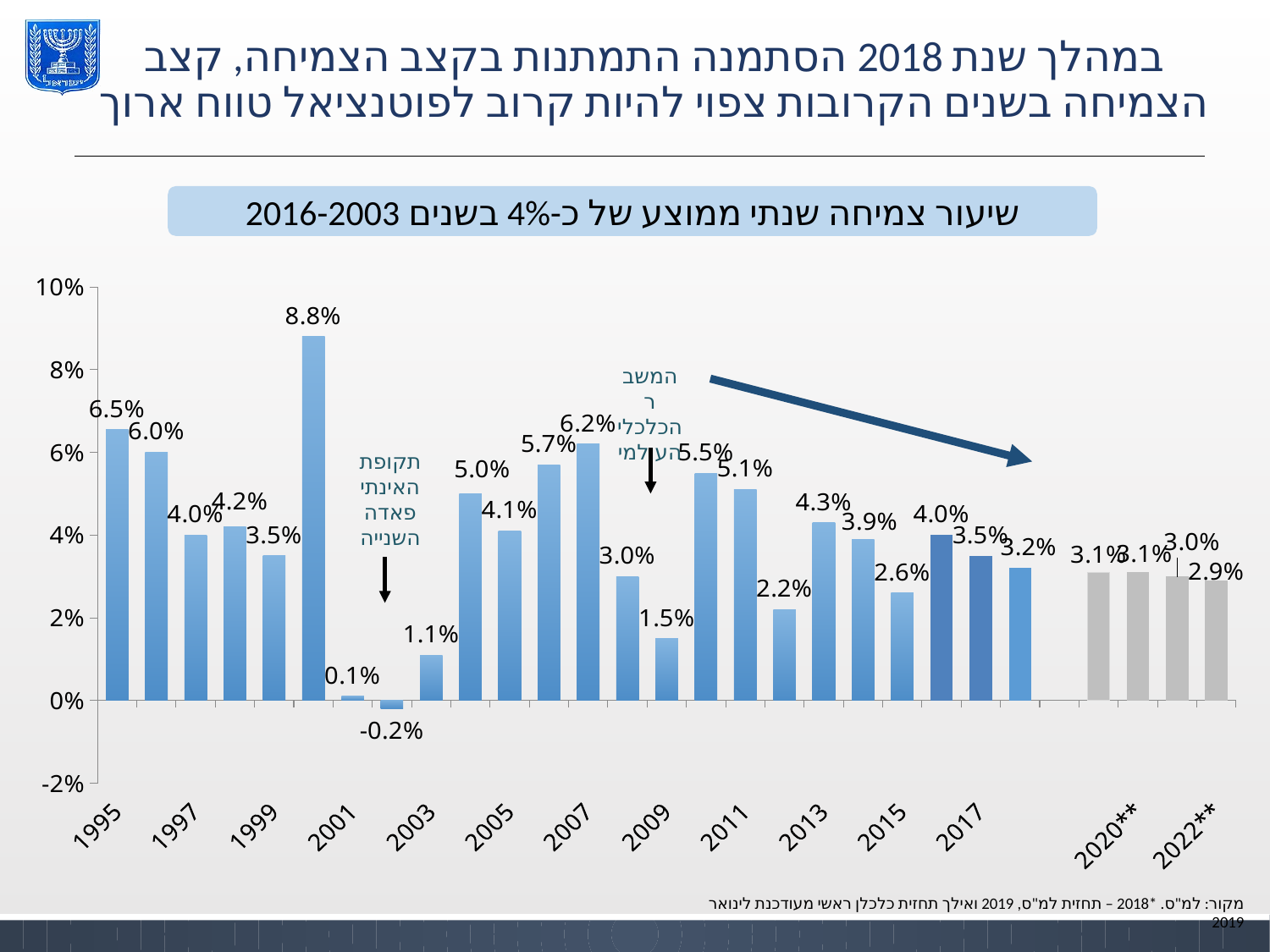
What is the growth rate shown for 2017? 3.5% What is the difference between the growth rates for 2007 and 2009? 4.7 percentage points What type of chart is shown on the slide? bar chart Which year has the highest growth rate in the chart? 2000 What is the growth rate shown for 2007? 6.2% What is the title shown in the box above the chart? שיעור צמיחה שנתי ממוצע של כ-4% בשנים 2016-2003 What is the growth rate shown for 1995? 6.5% What is the growth rate shown for 2020**? 3.1% What is the lowest value shown in the chart? -0.2% What is the growth rate shown for 2009? 1.5% Which is larger, the growth rate for 1995 or for 2011? 1995 Is the value for 2000 greater or less than 8%? greater